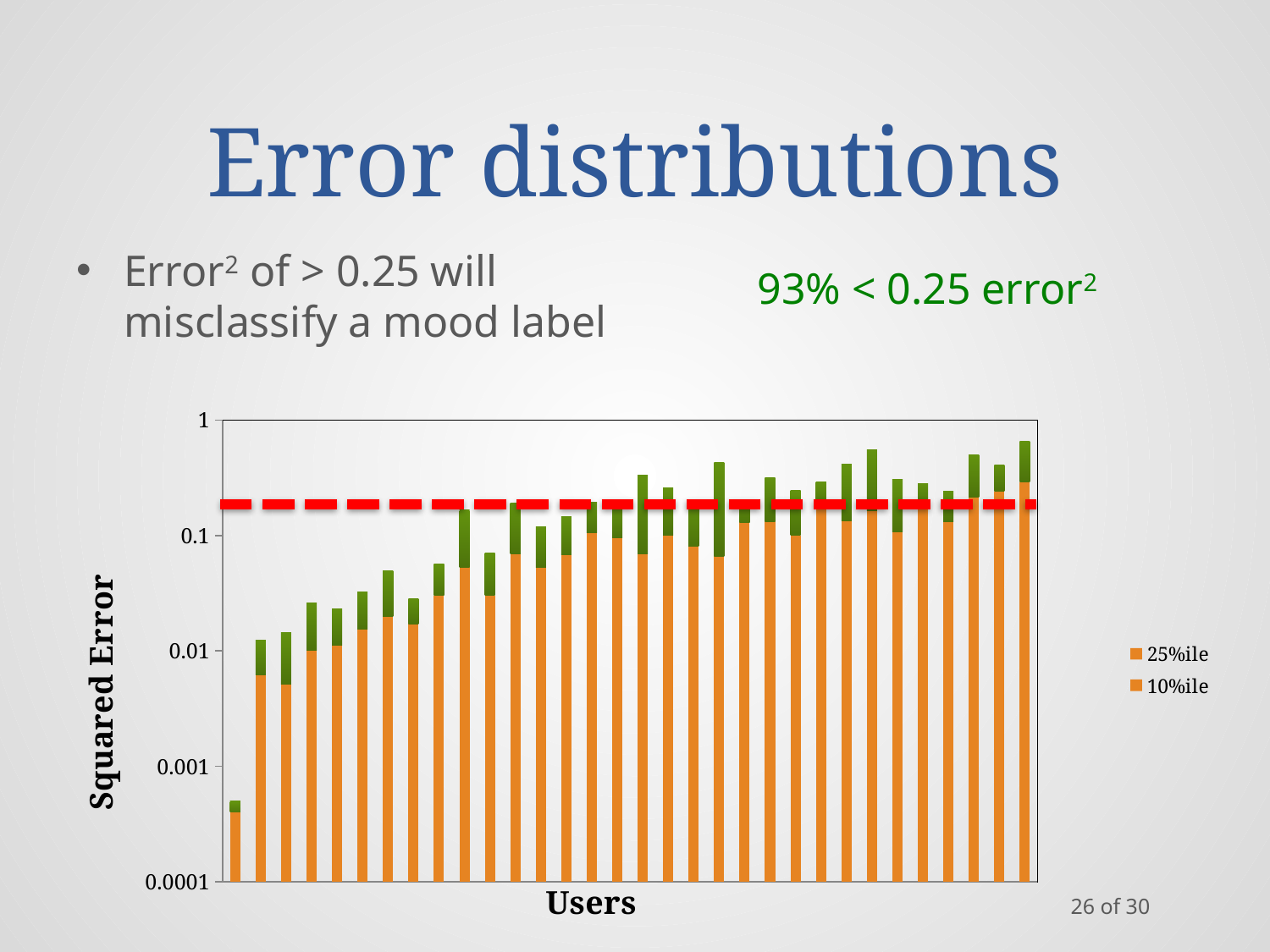
Is the 10%ile value of the leftmost bar greater or less than 0.01? less Is the total value of the rightmost bar greater or less than 0.1? greater Which is larger, the total of the leftmost bar or the total of the rightmost bar? rightmost bar Is the total value of the leftmost bar greater or less than 0.001? less What is the title of the y axis? Squared Error Do the bar heights generally rise or fall from left to right along the x axis? rise What kind of chart is shown on the slide? bar chart What are the two series named in the legend? 25%ile and 10%ile How many series does the legend list? 2 Which bar has the lowest squared error, the leftmost or the rightmost? leftmost